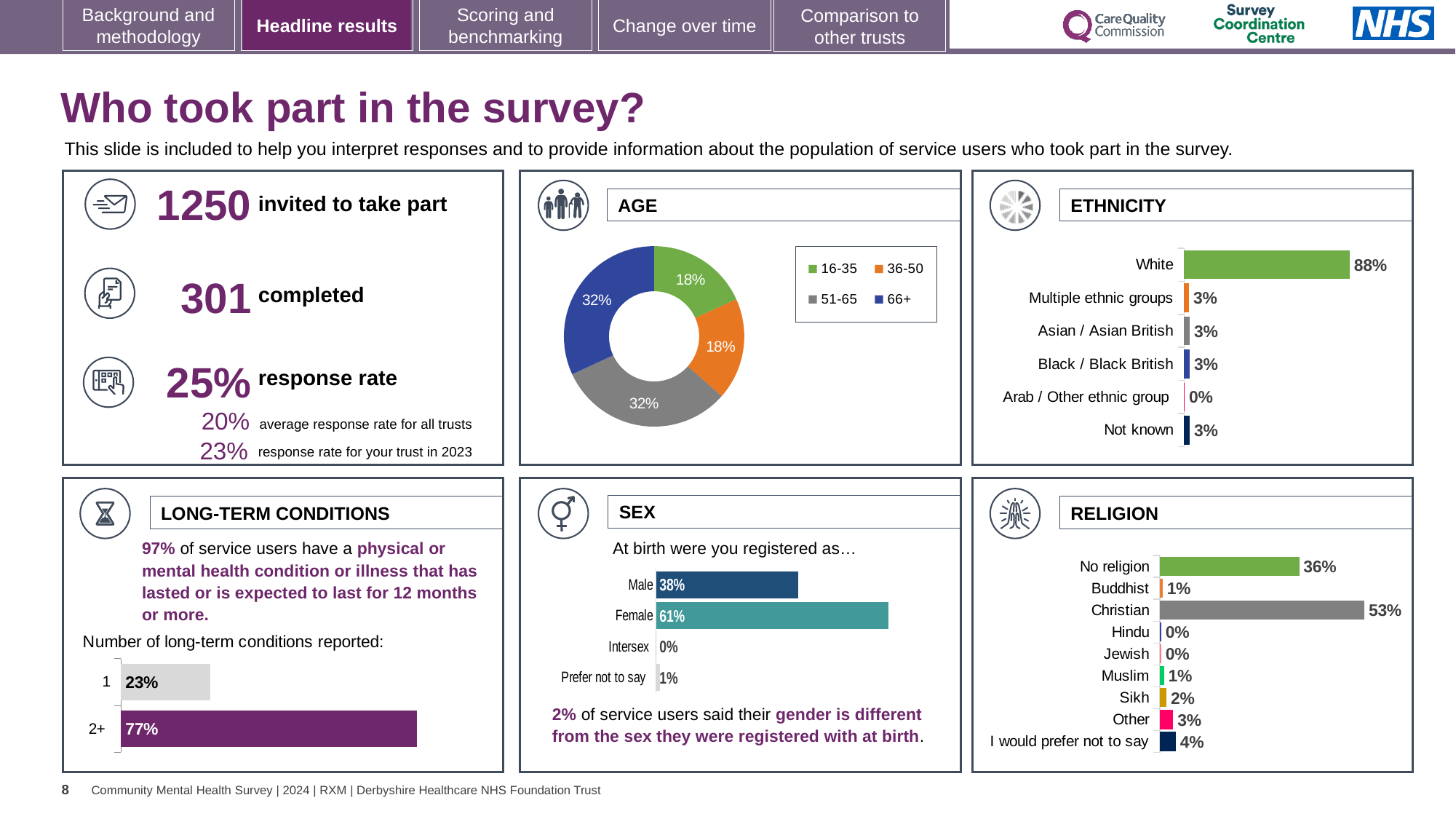
In the AGE chart, how many age groups does the legend list? 4 In the LONG-TERM CONDITIONS chart, what percentage reported 2+ long-term conditions? 77% In the SEX chart, what is the difference between the Female and Male percentages? 23% In the SEX chart, which is larger, Male or Female? Female In the RELIGION chart, what percentage of respondents are Christian? 53% In the AGE chart, what share of respondents are aged 51-65? 32% In the RELIGION chart, how many religion categories are shown? 9 What kind of chart is the AGE chart? Donut (pie) chart In the ETHNICITY chart, which category has the lowest value? Arab / Other ethnic group In the ETHNICITY chart, how many ethnic categories are shown? 6 In the ETHNICITY chart, what percentage of respondents are White? 88% In the ETHNICITY chart, which category has the highest value? White